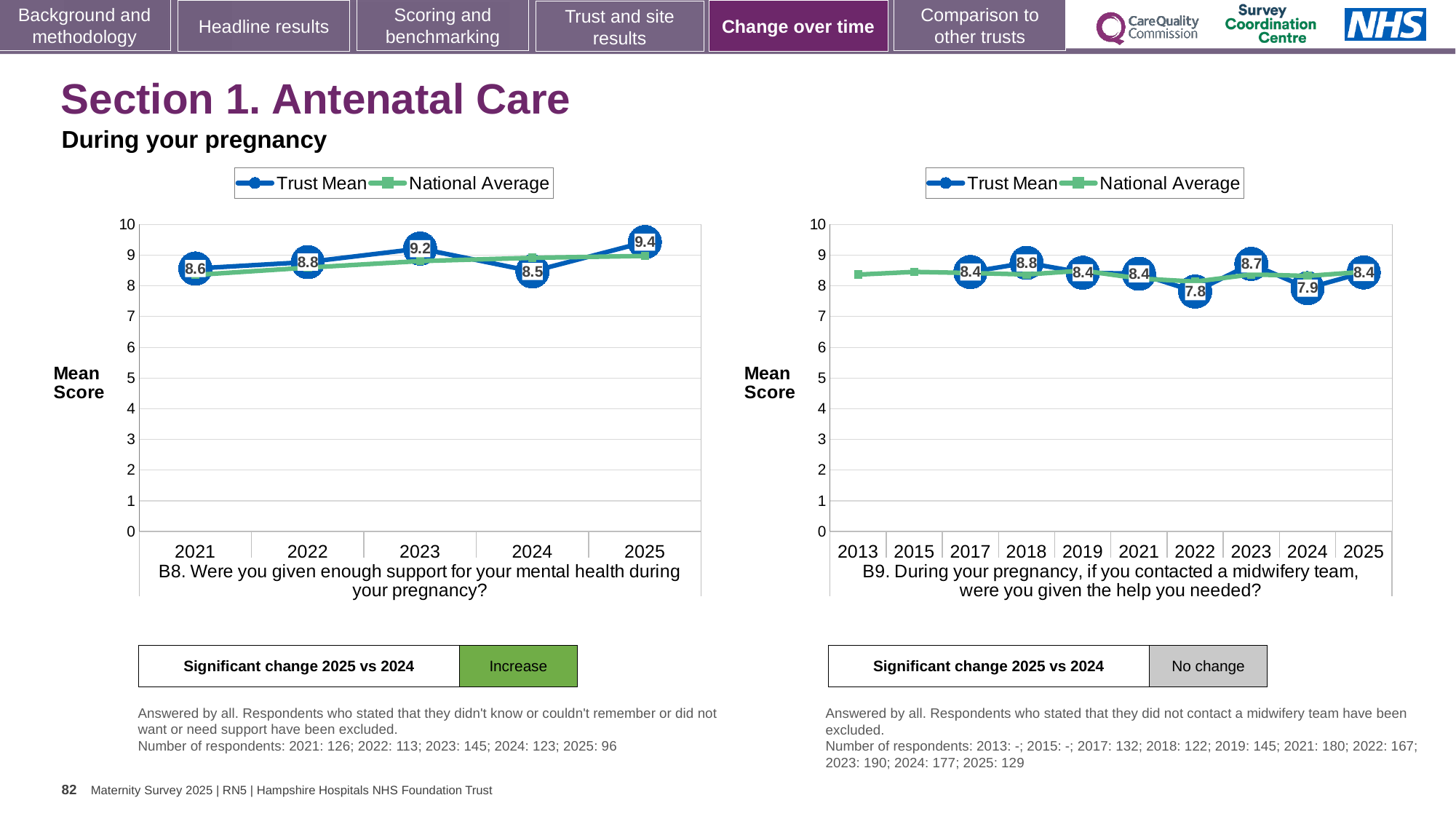
In the B8 chart, what is the Trust Mean score for 2021? 8.6 In the B9 chart, how many years are shown on the x axis? 10 What kind of chart is the B9 chart? line chart In the B8 chart, which year has the lowest Trust Mean score? 2024 In the B9 chart, what is the Trust Mean score for 2022? 7.8 In the B8 chart, what is the Trust Mean score for 2025? 9.4 How many series does the legend of the B8 chart list? 2 In the B9 chart, is the Trust Mean score for 2023 larger or smaller than the Trust Mean score for 2024? larger In the B9 chart, which year has the lowest Trust Mean score? 2022 In the B8 chart, how many years are shown on the x axis? 5 In the B8 chart, what is the difference between the Trust Mean scores for 2025 and 2024? 0.9 In the B9 chart, which year has the highest Trust Mean score? 2018